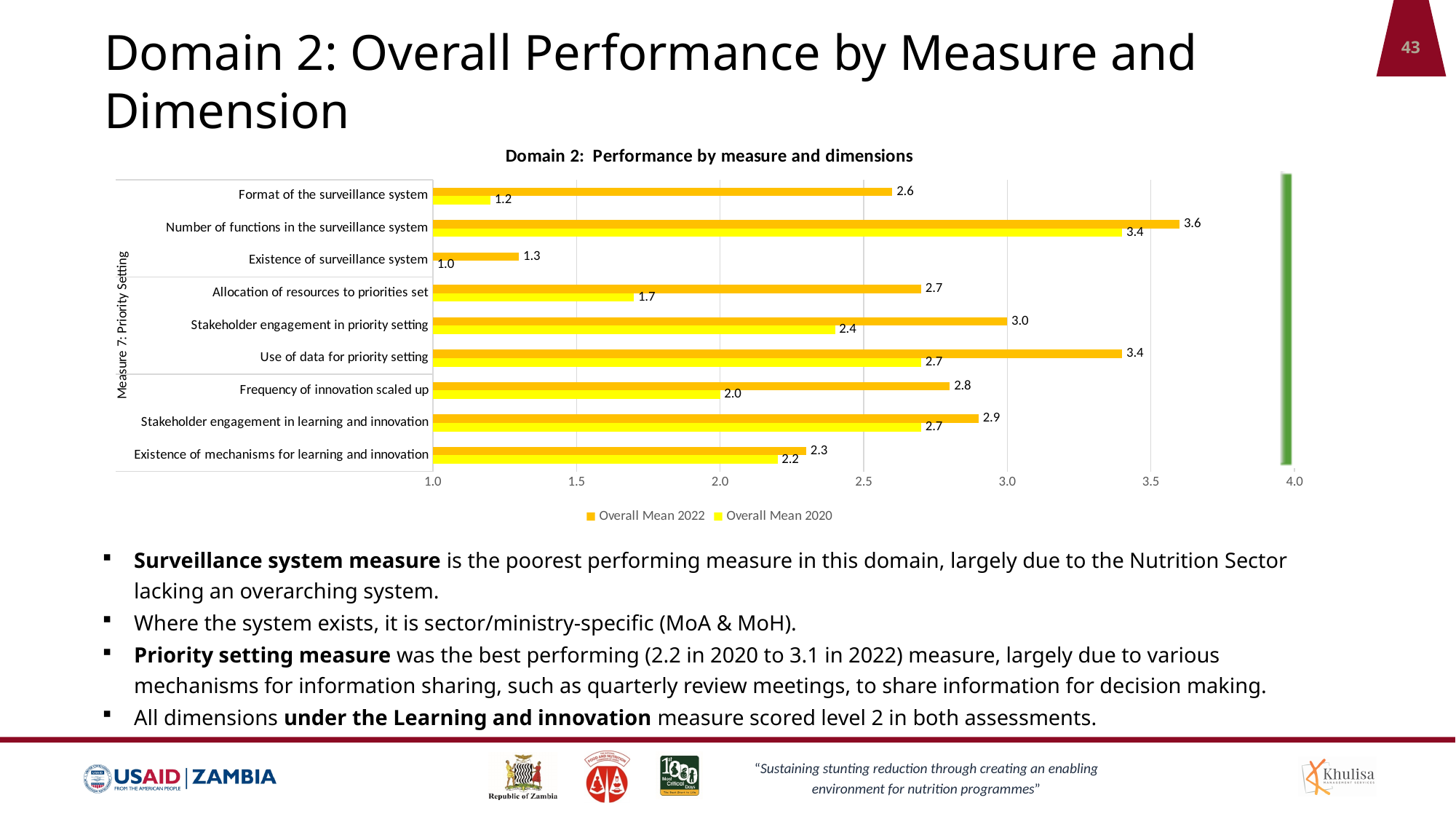
How many dimensions are plotted in the chart? 9 What is the Overall Mean 2022 value for Number of functions in the surveillance system? 3.6 Is the Overall Mean 2022 value for Existence of surveillance system greater or less than 1.5? less What is the Overall Mean 2020 value for Format of the surveillance system? 1.2 Which is larger for Use of data for priority setting: the Overall Mean 2022 value or the Overall Mean 2020 value? Overall Mean 2022 What kind of chart is shown on the slide? Bar chart How many series does the legend list? 2 What is the title of the chart? Domain 2: Performance by measure and dimensions What is the Overall Mean 2022 value for Stakeholder engagement in priority setting? 3.0 Which dimension has the highest Overall Mean 2022 value? Number of functions in the surveillance system What is the difference between the Overall Mean 2022 and Overall Mean 2020 values for Allocation of resources to priorities set? 1.0 Which dimension has the lowest Overall Mean 2020 value? Existence of surveillance system